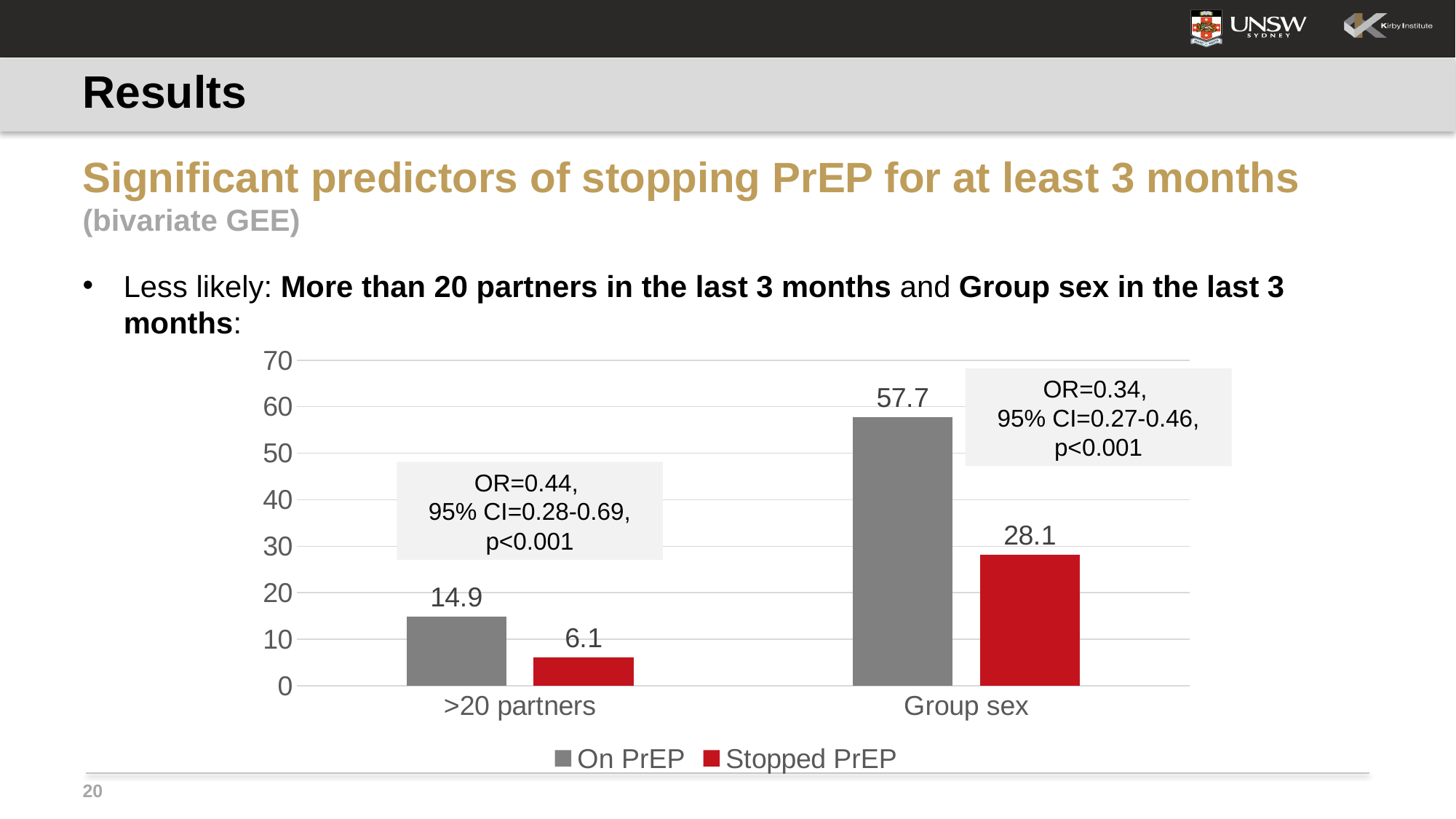
What is the difference between the On PrEP and Stopped PrEP values for >20 partners? 8.8 Which category has the highest On PrEP value? Group sex What is the value for On PrEP in the >20 partners category? 14.9 How many categories are shown on the x axis? 2 How many series does the legend list? 2 What is the value for Stopped PrEP in the Group sex category? 28.1 Which bar has the lowest value in the chart? Stopped PrEP, >20 partners What kind of chart is shown on the slide? Bar chart What is the value for On PrEP in the Group sex category? 57.7 What is the value for Stopped PrEP in the >20 partners category? 6.1 Which is larger: the Stopped PrEP value for Group sex or the On PrEP value for >20 partners? Stopped PrEP value for Group sex What is the difference between the On PrEP and Stopped PrEP values for Group sex? 29.6